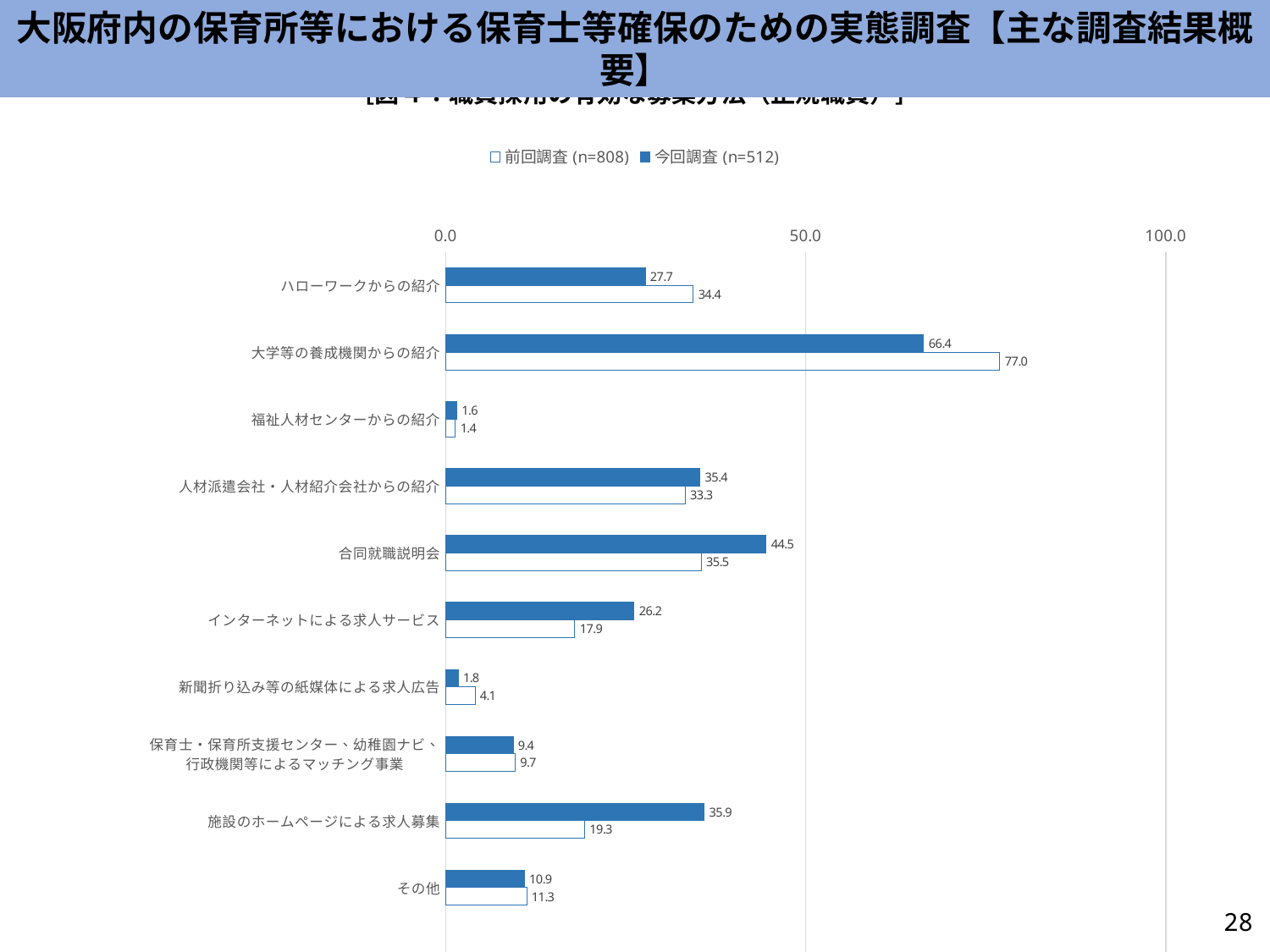
Which series is drawn with solid blue bars? 今回調査 (n=512) What kind of chart is shown on the slide? bar chart What is the value for 今回調査 (n=512) for ハローワークからの紹介? 27.7 What is the value for 今回調査 (n=512) for 施設のホームページによる求人募集? 35.9 What is the value for 前回調査 (n=808) for 大学等の養成機関からの紹介? 77.0 Which category has the highest value for 今回調査 (n=512)? 大学等の養成機関からの紹介 How many series does the legend list? 2 What is the difference between the 前回調査 (n=808) and 今回調査 (n=512) values for 合同就職説明会? 9.0 Which category has the lowest value for 前回調査 (n=808)? 福祉人材センターからの紹介 For インターネットによる求人サービス, which is larger: the 前回調査 (n=808) value or the 今回調査 (n=512) value? 今回調査 (n=512) Is the 今回調査 (n=512) value for 大学等の養成機関からの紹介 greater or less than 50.0? greater How many categories are shown on the chart? 10